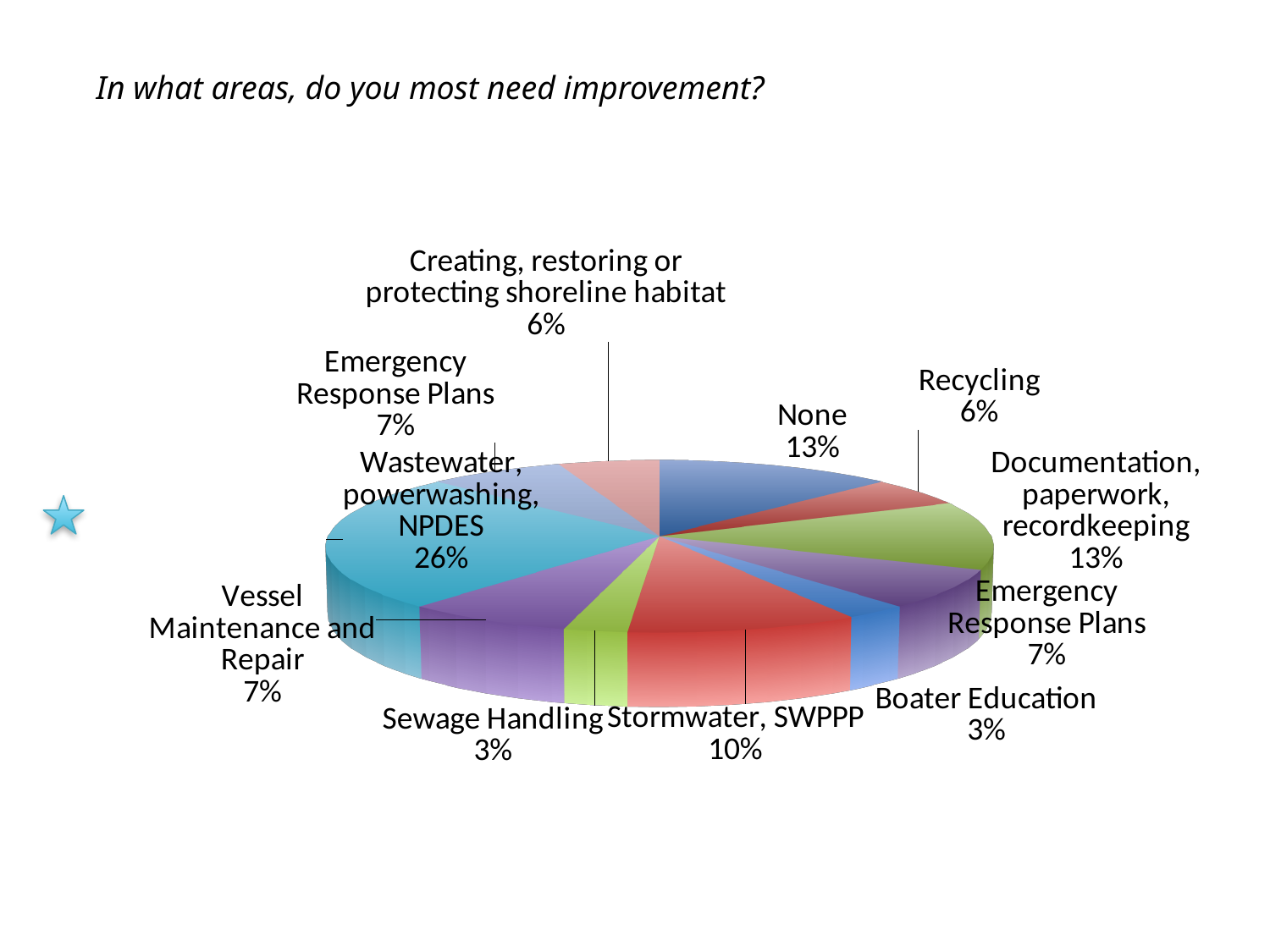
Which is larger, the share for Stormwater, SWPPP or the share for Recycling? Stormwater, SWPPP What percentage is shown for None? 13% What is the title of the chart? In what areas, do you most need improvement? What percentage is shown for Stormwater, SWPPP? 10% What kind of chart is shown on the slide? pie chart What is the difference between the Wastewater, powerwashing, NPDES share and the None share? 13% What percentage is shown for Vessel Maintenance and Repair? 7% Which category has the largest slice of the pie? Wastewater, powerwashing, NPDES What percentage is shown for Recycling? 6% How many slices does the pie chart have? 11 What percentage is shown for Documentation, paperwork, recordkeeping? 13% What share of the pie is Wastewater, powerwashing, NPDES? 26%